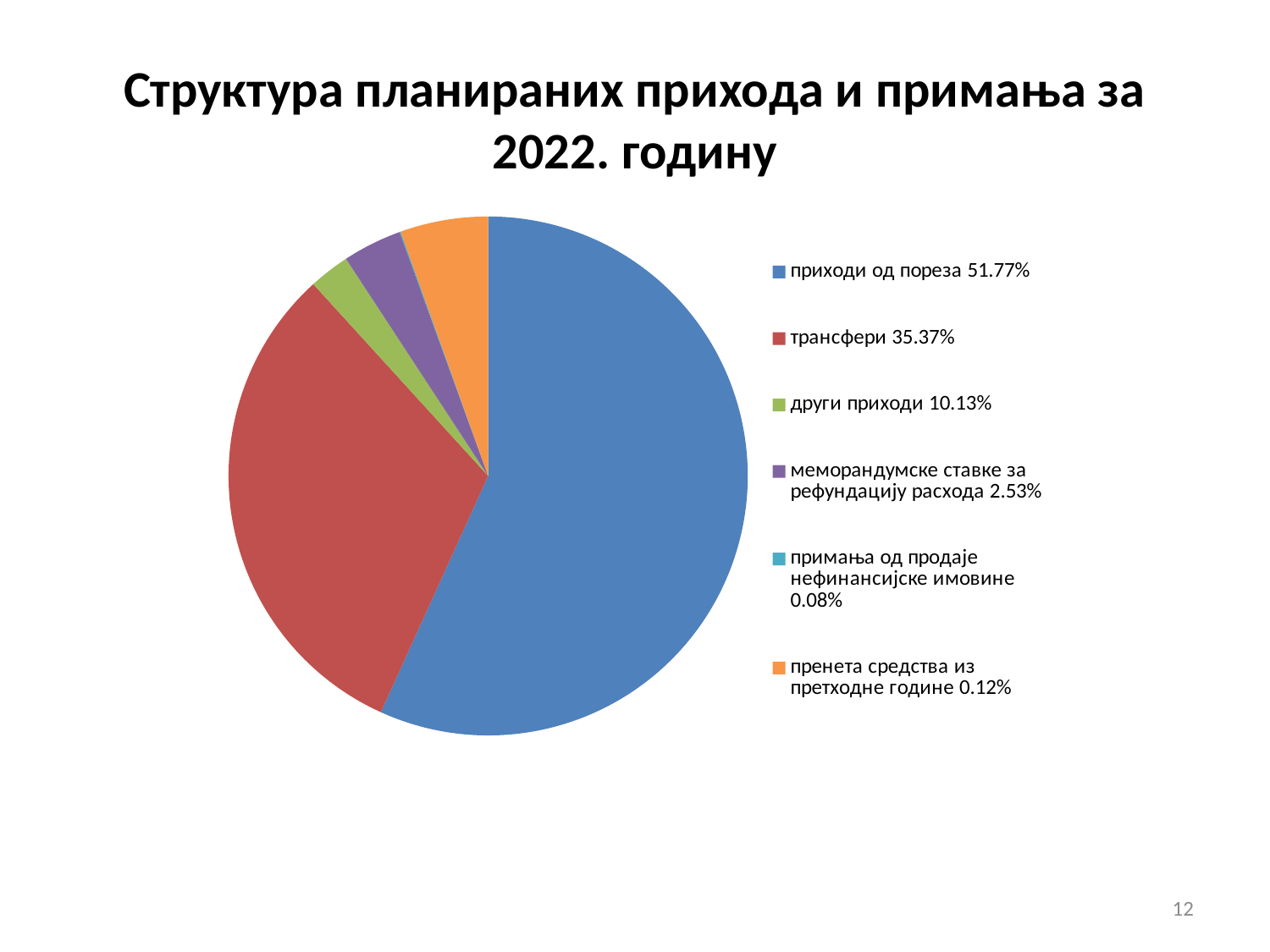
How many categories does the pie chart have? 6 What kind of chart is shown on the slide? pie chart What share of the pie does "трансфери" have? 35.37% Which category has the largest share of the pie? приходи од пореза What is the value shown for "пренета средства из претходне године"? 0.12% What is the difference between the shares of "приходи од пореза" and "трансфери"? 16.40% What is the value shown for "меморандумске ставке за рефундацију расхода"? 2.53% Which category has the smallest share of the pie? примања од продаје нефинансијске имовине What share of the pie does "приходи од пореза" have? 51.77% What is the value shown for "примања од продаје нефинансијске имовине"? 0.08% What is the title of the chart on the slide? Структура планираних прихода и примања за 2022. годину What is the value shown for "други приходи"? 10.13%